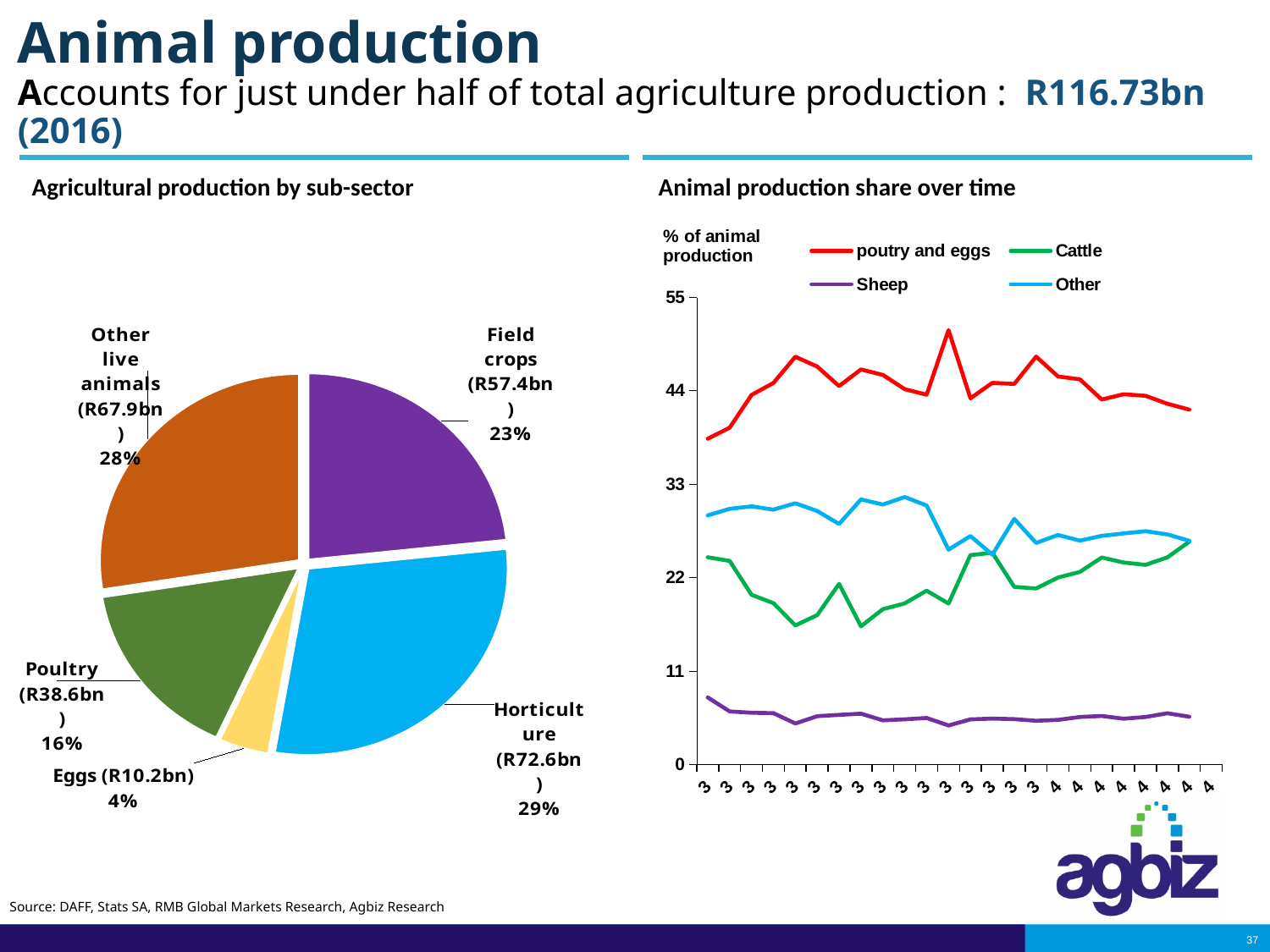
In the 'Agricultural production by sub-sector' pie chart, which is larger: Poultry or Field crops? Field crops What kind of chart is 'Agricultural production by sub-sector'? Pie chart In the 'Agricultural production by sub-sector' pie chart, which sub-sector has the smallest slice? Eggs What kind of chart is 'Animal production share over time'? Line chart In the 'Agricultural production by sub-sector' pie chart, what is the difference in value between Horticulture and Other live animals? R4.7bn In the 'Animal production share over time' chart, are the values for Sheep greater or less than 11? less How many series does the legend of the 'Animal production share over time' chart list? 4 How many slices does the 'Agricultural production by sub-sector' pie chart have? 5 In the 'Agricultural production by sub-sector' pie chart, which sub-sector has the largest slice? Horticulture In the 'Agricultural production by sub-sector' pie chart, what is the value shown for Field crops? R57.4bn In the 'Animal production share over time' chart, which series has the highest values throughout? poutry and eggs In the 'Agricultural production by sub-sector' pie chart, what share does Horticulture account for? 29%